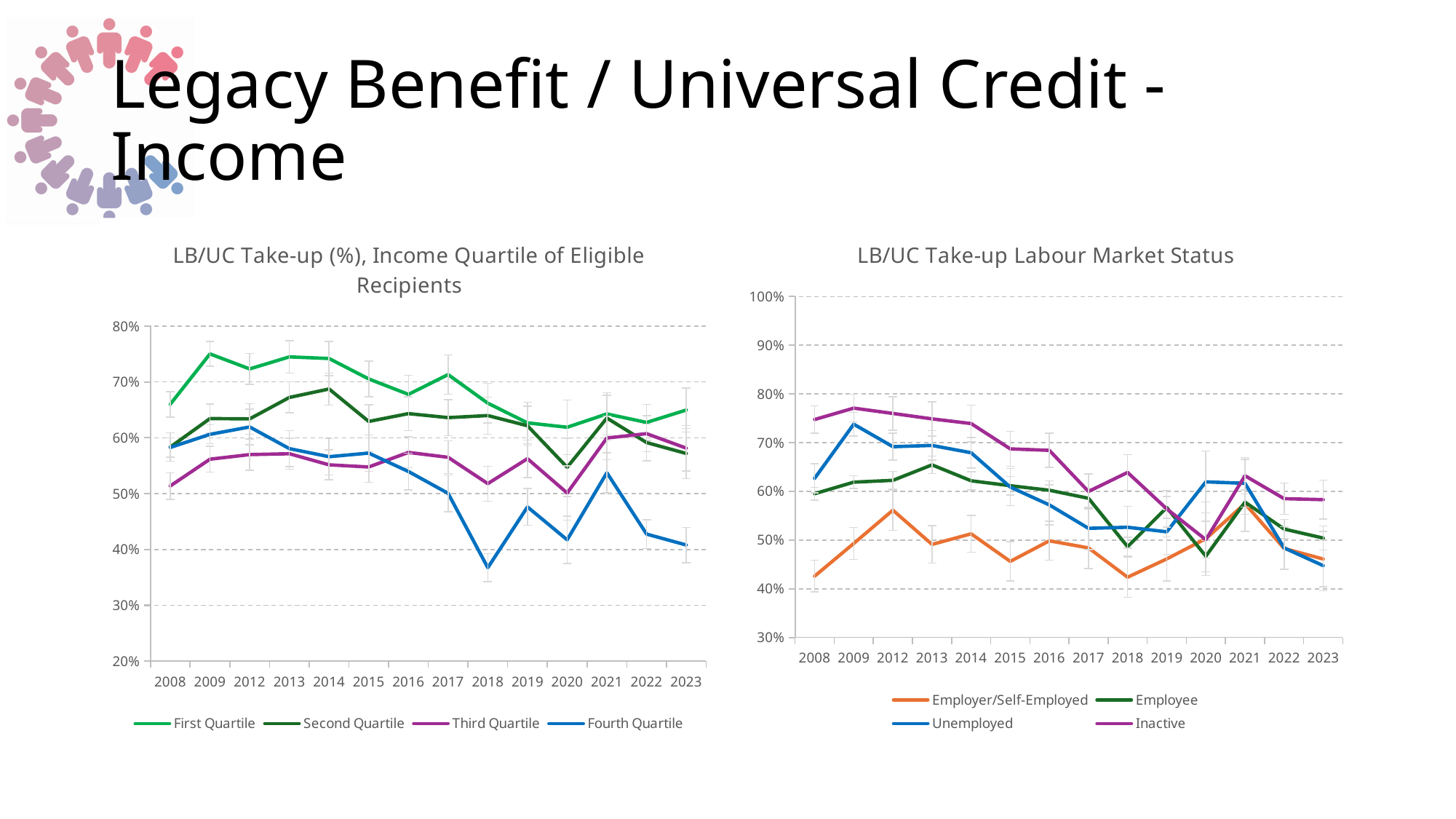
In the right chart, 'LB/UC Take-up Labour Market Status', which series has the lowest value in 2018? Employer/Self-Employed In the left chart, 'LB/UC Take-up (%), Income Quartile of Eligible Recipients', is the Fourth Quartile value for 2018 greater or less than 40%? less In the left chart, 'LB/UC Take-up (%), Income Quartile of Eligible Recipients', which series has the lowest value in 2018? Fourth Quartile In the left chart, 'LB/UC Take-up (%), Income Quartile of Eligible Recipients', which series has the highest value in 2009? First Quartile In the right chart, 'LB/UC Take-up Labour Market Status', which is larger in 2012: Employer/Self-Employed or Unemployed? Unemployed In the left chart, 'LB/UC Take-up (%), Income Quartile of Eligible Recipients', is the First Quartile value for 2009 greater or less than 70%? greater In the right chart, 'LB/UC Take-up Labour Market Status', which series has the highest value in 2008? Inactive In the right chart, 'LB/UC Take-up Labour Market Status', is the Unemployed value for 2023 greater or less than 50%? less How many years are shown on the x axis of the left chart, 'LB/UC Take-up (%), Income Quartile of Eligible Recipients'? 14 What type of chart is the left chart, 'LB/UC Take-up (%), Income Quartile of Eligible Recipients'? Line chart How many series does the legend of the right chart, 'LB/UC Take-up Labour Market Status', list? 4 In the left chart, 'LB/UC Take-up (%), Income Quartile of Eligible Recipients', does the Fourth Quartile line rise or fall overall from 2008 to 2023? Fall